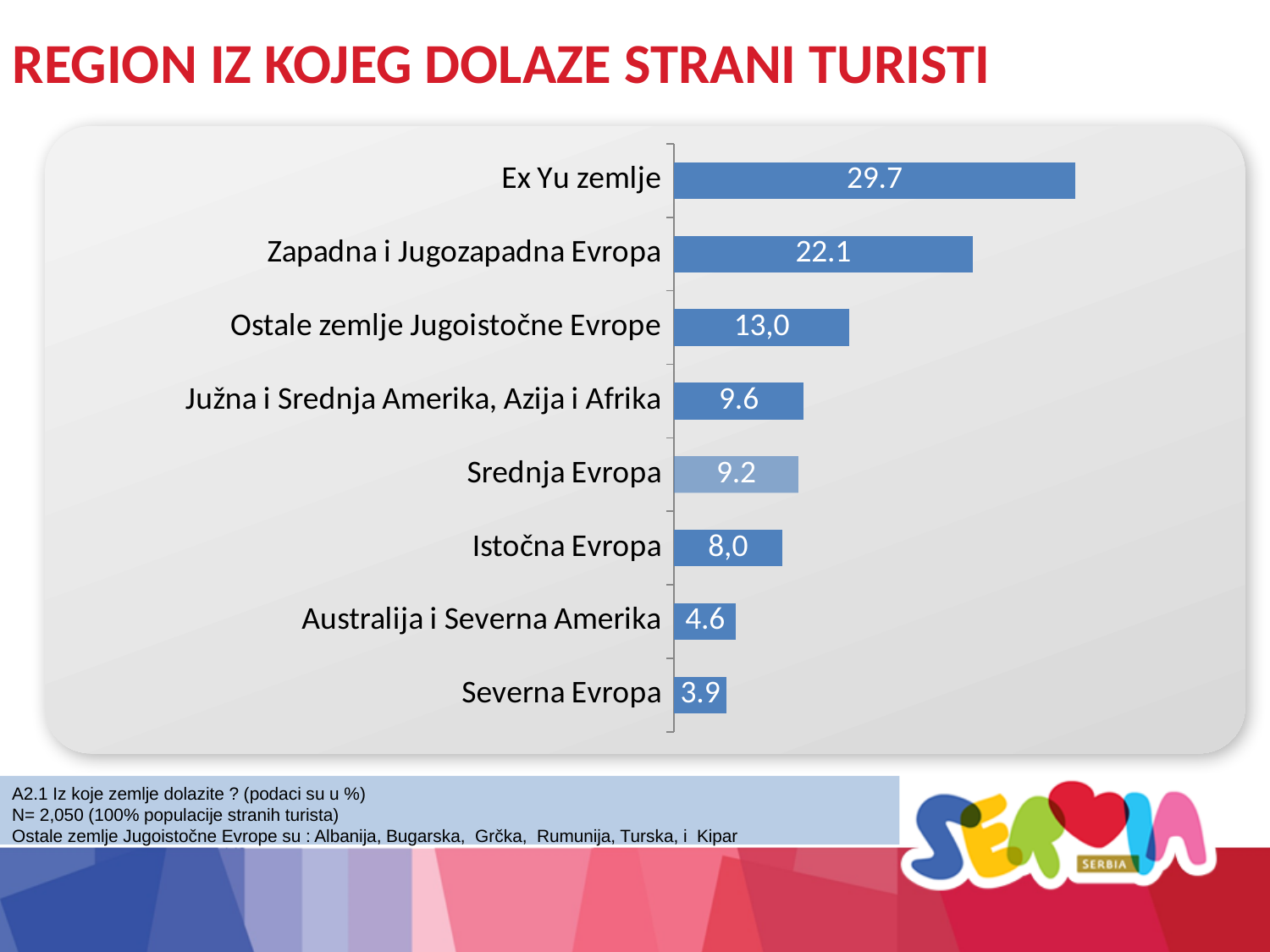
What is the value for Australija i Severna Amerika? 4.6 What is the difference between the values for Australija i Severna Amerika and Severna Evropa? 0.7 Which is larger, the value for Srednja Evropa or the value for Istočna Evropa? Srednja Evropa What is the value for Ex Yu zemlje? 29.7 What is the difference between the values for Ex Yu zemlje and Zapadna i Jugozapadna Evropa? 7.6 Which region has the highest value? Ex Yu zemlje What is the title of the slide? REGION IZ KOJEG DOLAZE STRANI TURISTI How many regions are shown in the chart? 8 Which region has the lowest value? Severna Evropa What kind of chart is shown on the slide? Bar chart What is the value for Ostale zemlje Jugoistočne Evrope? 13,0 What is the value for Istočna Evropa? 8,0